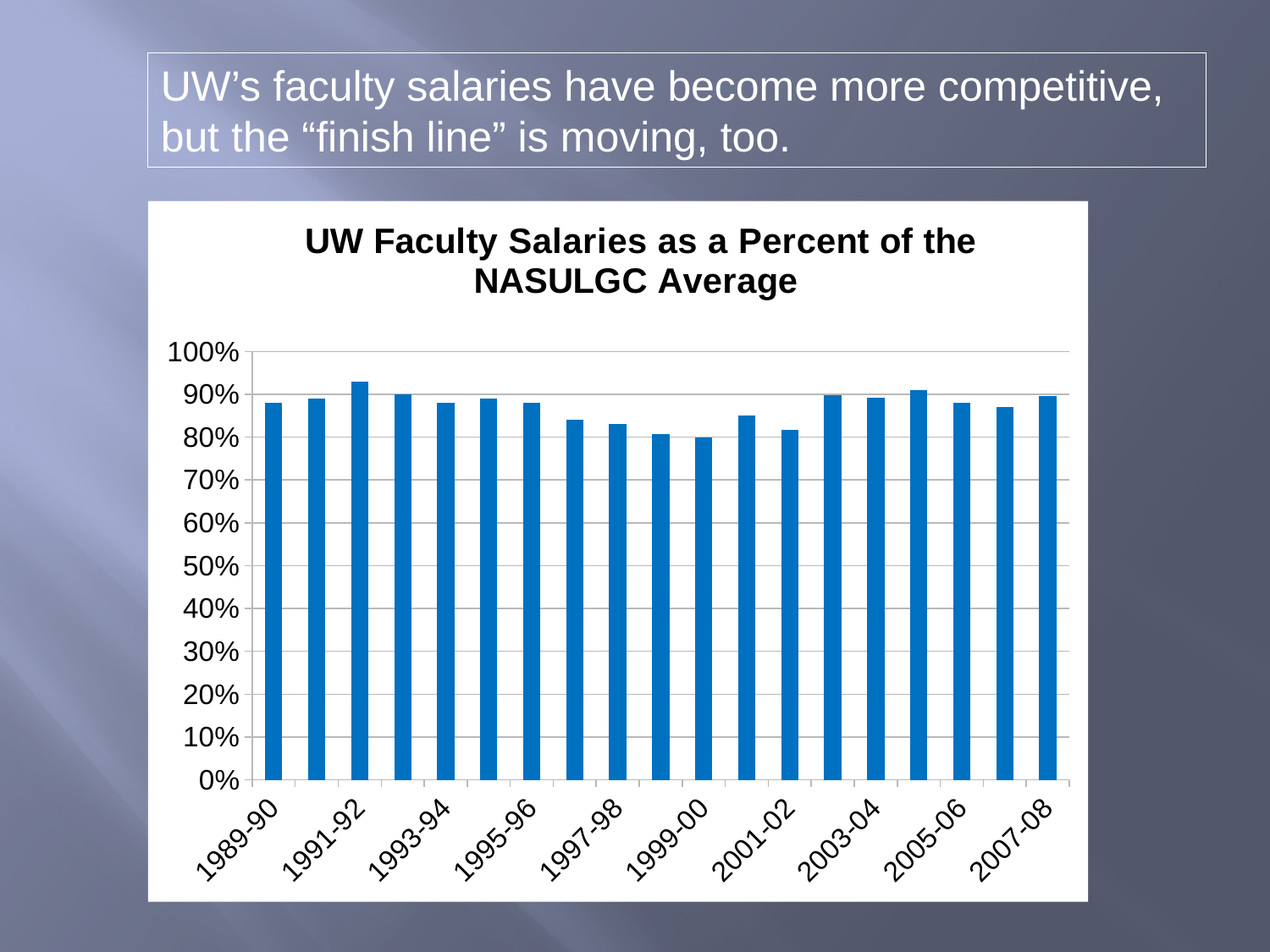
What is the highest value shown on the vertical axis? 100% Is the value for 1989-90 greater or less than 80%? greater Which is larger, the value for 1989-90 or the value for 1997-98? 1989-90 Which is larger, the value for 1991-92 or the value for 1999-00? 1991-92 How many bars are plotted in the chart? 19 Which year has the highest bar in the chart? 1991-92 What is the title of the chart? UW Faculty Salaries as a Percent of the NASULGC Average Is the value for 2007-08 greater or less than 80%? greater What kind of chart is shown on the slide? bar chart Do the values rise or fall from 1991-92 to 1999-00? fall Is the value for 1997-98 greater or less than 90%? less